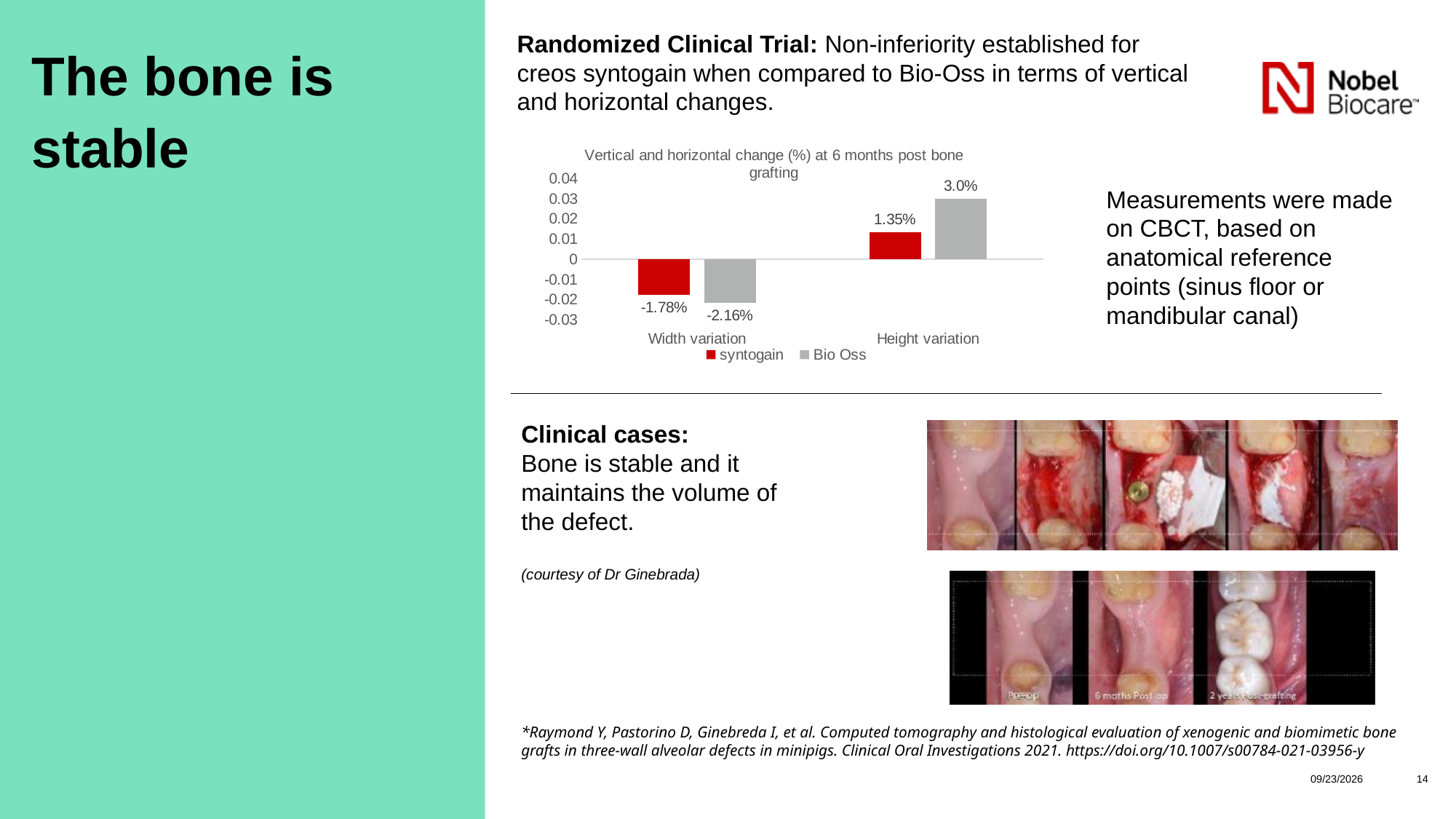
What is the difference between the Bio Oss and syntogain values in the Height variation category? 1.65% What is the value for syntogain in the Height variation category? 1.35% How many series does the legend list? 2 What is the title of the chart? Vertical and horizontal change (%) at 6 months post bone grafting Which colour represents the syntogain series in the chart? Red Which series has the lower value in the Width variation category? Bio Oss How many categories are shown on the x axis? 2 What is the value for syntogain in the Width variation category? -1.78% Which series has the higher value in the Height variation category? Bio Oss What kind of chart is shown on the slide? Bar chart What is the value for Bio Oss in the Width variation category? -2.16% What is the value for Bio Oss in the Height variation category? 3.0%